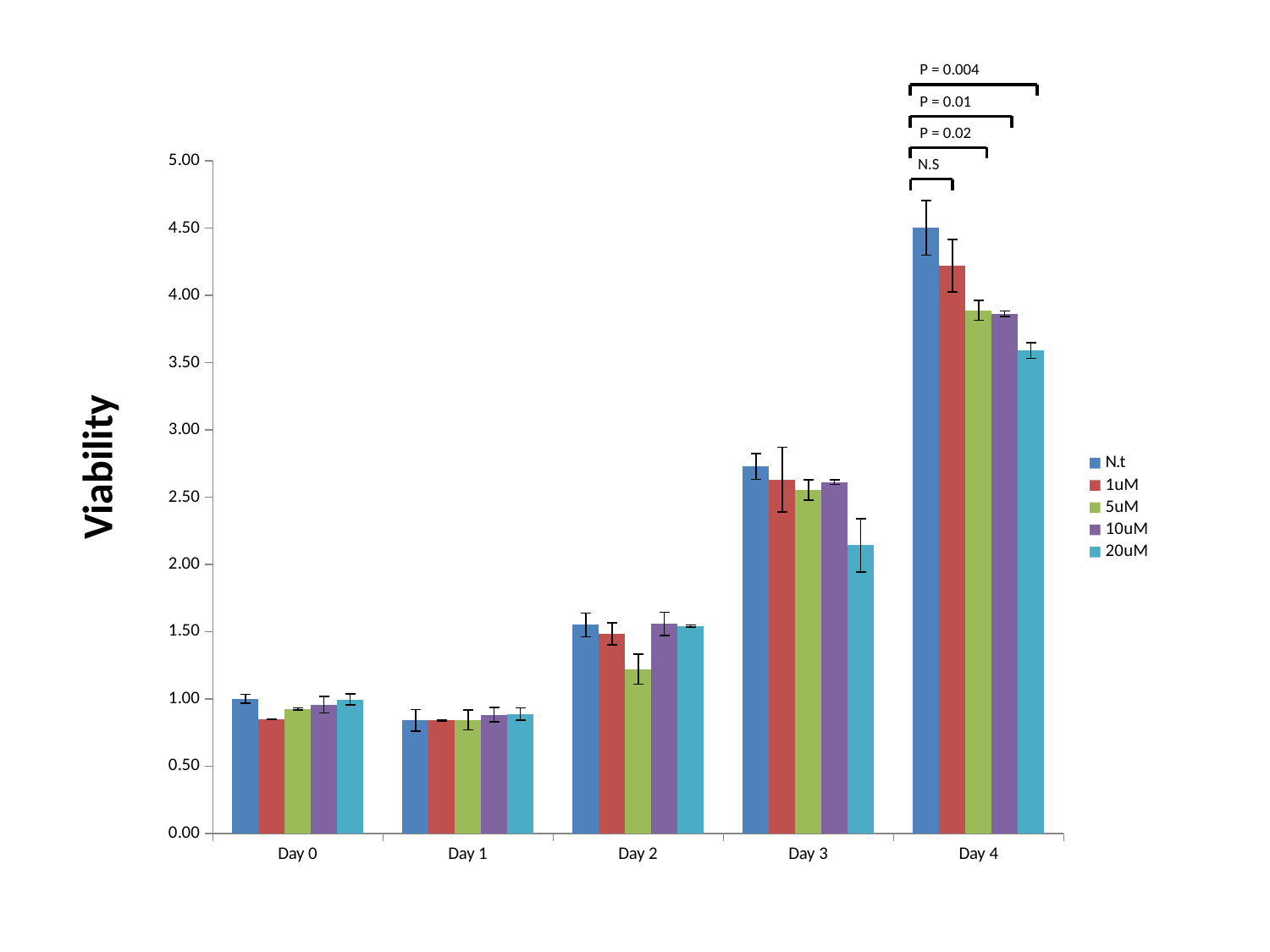
How many series does the legend list? 5 Within Day 4, which series has the lowest viability? 20uM What kind of chart is shown on the slide? bar chart Is the 5uM value on Day 2 greater or less than 1.50? less Is the N.t value on Day 4 greater or less than 4.00? greater What is the y-axis title of the chart? Viability Does the N.t viability rise or fall from Day 1 to Day 4? rise On Day 4, which is larger: the N.t value or the 20uM value? N.t On which day is the N.t viability highest? Day 4 On Day 2, which is larger: the N.t value or the 5uM value? N.t Is the 20uM value on Day 3 greater or less than 2.50? less How many day categories are shown on the x axis? 5